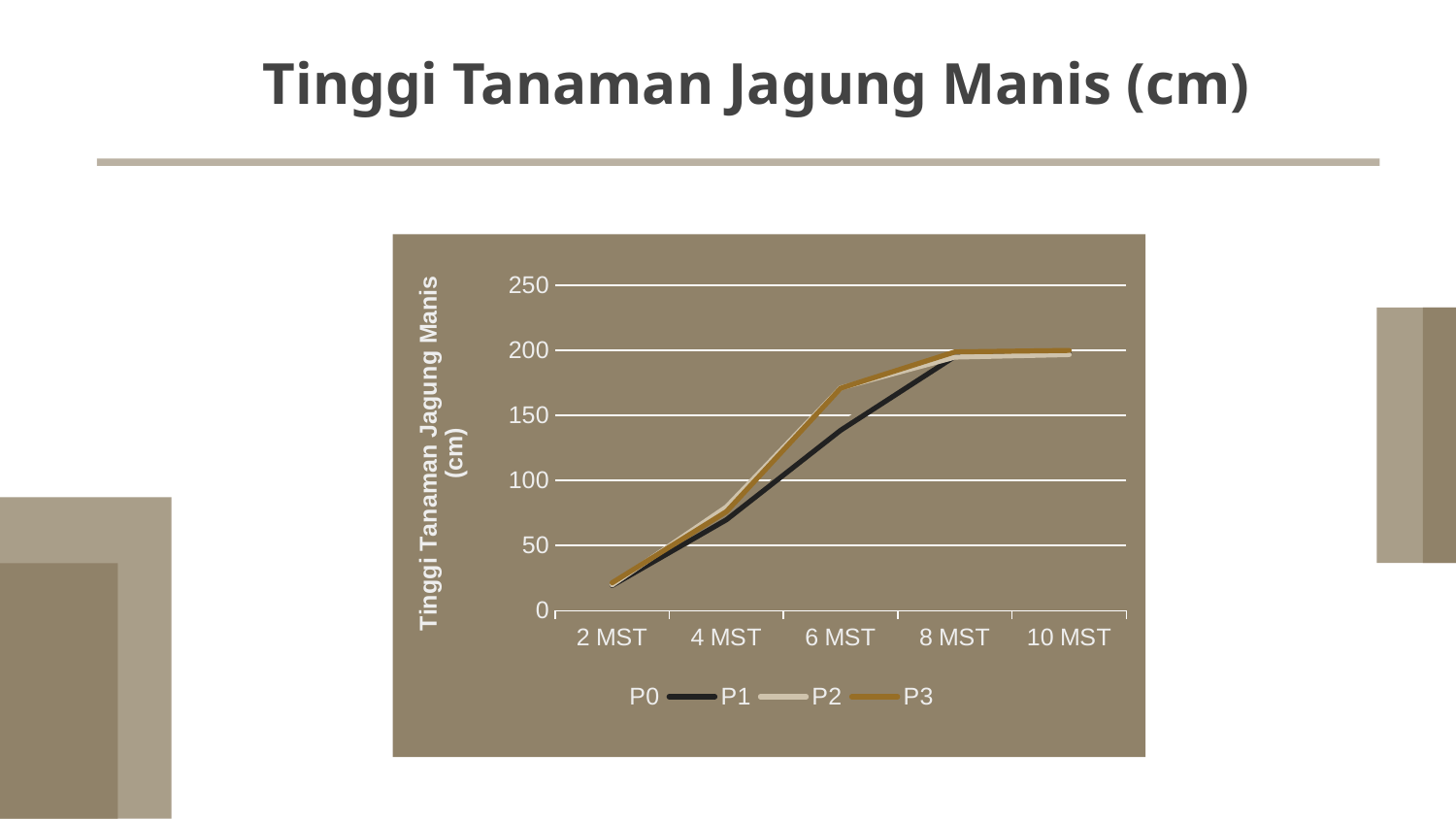
Do the values rise or fall from 2 MST to 10 MST? rise At 6 MST, which is larger, the value for P1 or the value for P3? P3 Is the value for P3 at 2 MST greater or less than 50? less How many points are there along the x axis? 5 What is the title of the chart? Tinggi Tanaman Jagung Manis (cm) Is the value for P3 at 6 MST greater or less than 150? greater Is the value for P3 at 10 MST greater or less than 150? greater How many series does the legend list? 4 What kind of chart is shown on the slide? line chart What is the label of the y axis? Tinggi Tanaman Jagung Manis (cm)